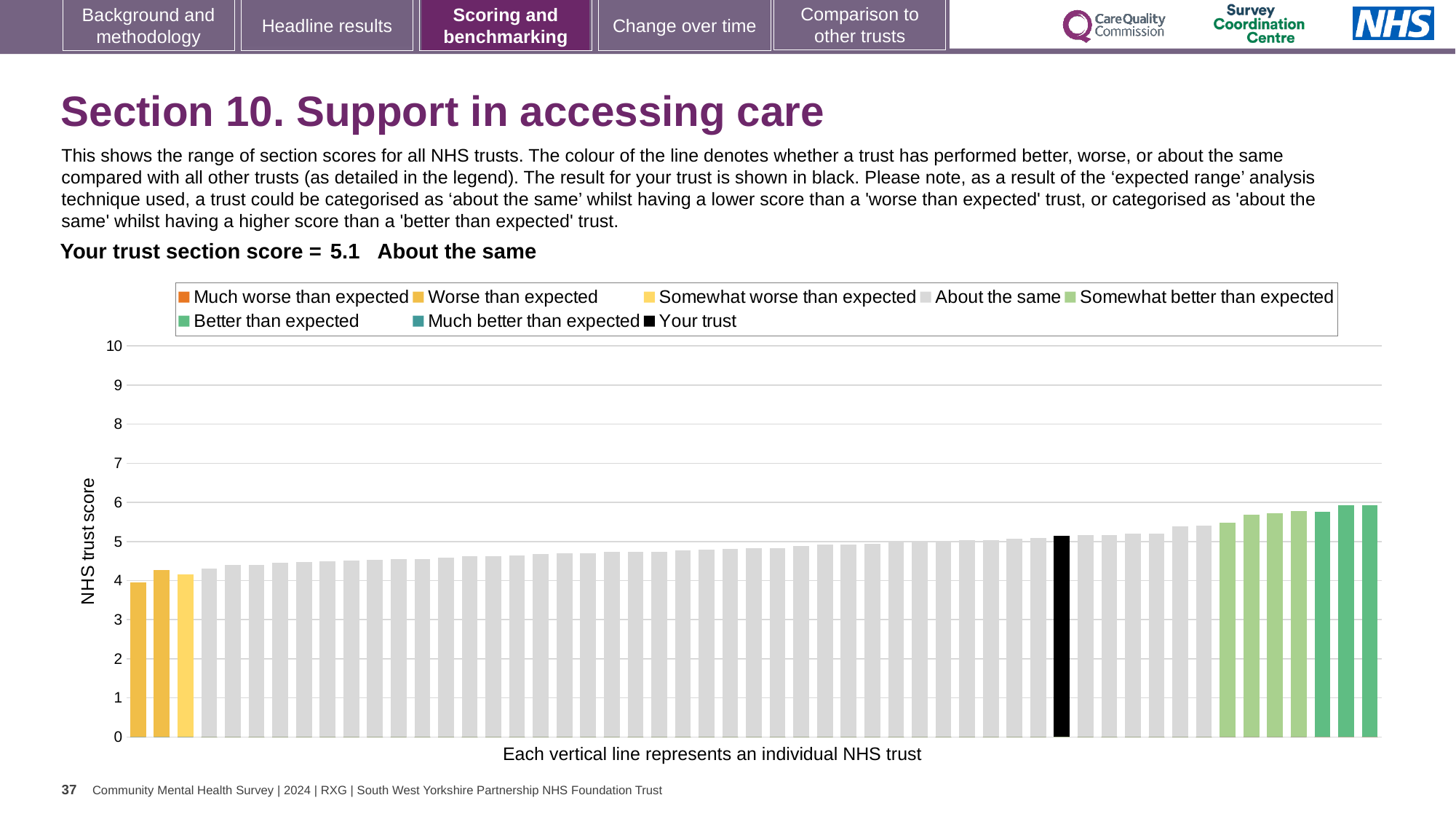
What colour is used for the bar representing your trust? black Is the value of the black bar (your trust) greater or less than 5? greater What is the label on the vertical axis of the chart? NHS trust score Is the value of the rightmost bar greater or less than 5? greater What type of chart is shown on the slide? bar chart Do the bar values rise or fall from left to right along the x axis? rise Is the value of the tallest bar in the chart greater or less than 6? less How many entries does the chart legend list? 8 What is the highest value shown on the vertical axis of the chart? 10 What is the section score for your trust shown on the slide? 5.1 How is your trust categorised compared with other trusts, according to the text above the chart? About the same